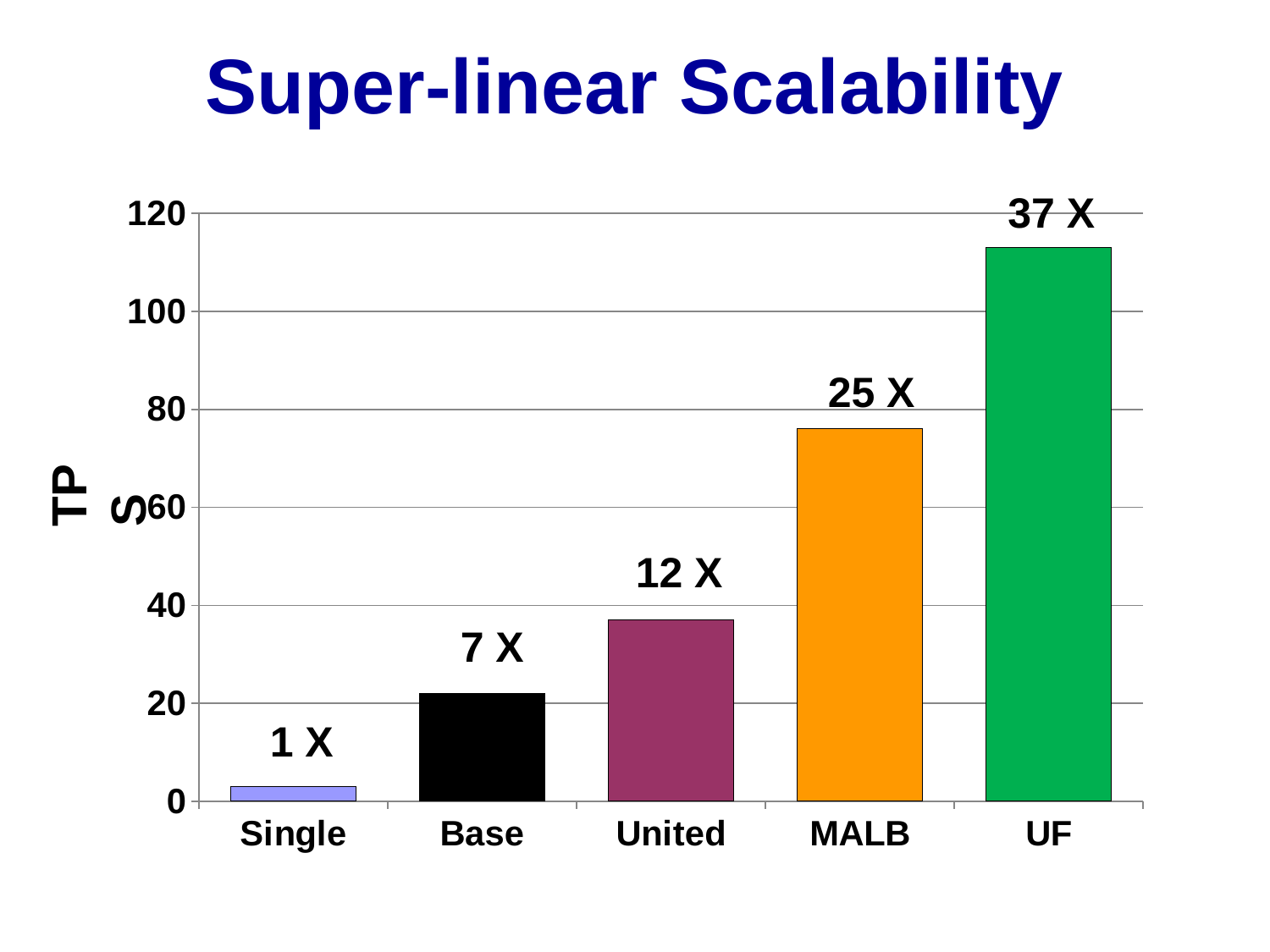
Is the value for UF greater or less than 100? greater Which is larger, the value for MALB or the value for United? MALB What label is printed above the MALB bar? 25 X How many categories are shown on the x axis? 5 What is the title of the slide? Super-linear Scalability What label is printed above the UF bar? 37 X Which category has the highest bar? UF Is the value for Single greater or less than 20? less What kind of chart is shown on the slide? bar chart Do the values rise or fall from Single to UF along the x axis? rise Which category has the lowest bar? Single What label is printed above the United bar? 12 X